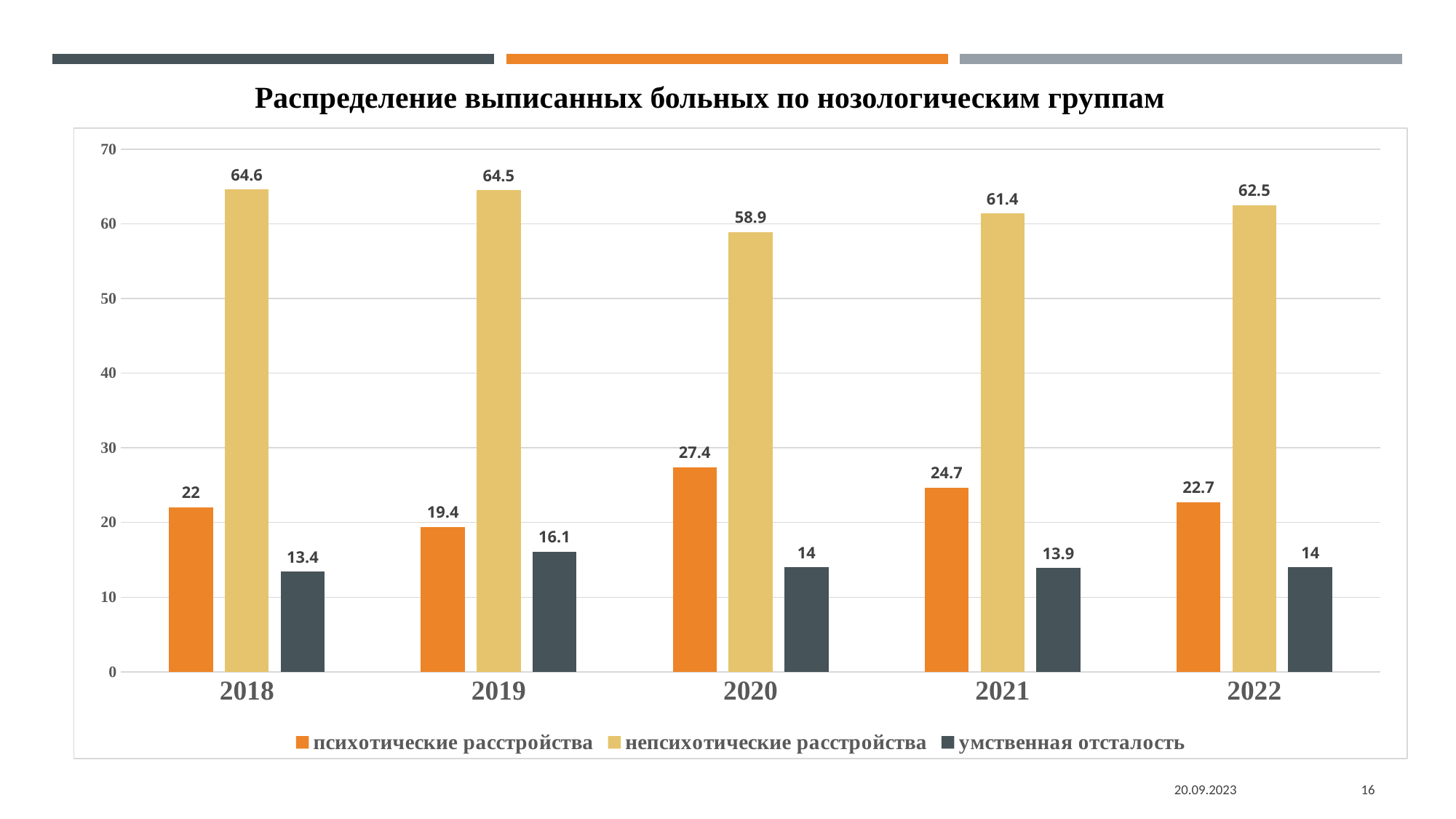
Which is larger: психотические расстройства in 2021 or психотические расстройства in 2022? психотические расстройства in 2021 In which year is the value for непсихотические расстройства the highest? 2018 In which year is the value for психотические расстройства the lowest? 2019 What is the title of the chart? Распределение выписанных больных по нозологическим группам What is the value for психотические расстройства in 2020? 27.4 What is the value for умственная отсталость in 2019? 16.1 How many years are shown on the x axis? 5 What kind of chart is shown on the slide? bar chart How many series does the legend list? 3 What is the value for непсихотические расстройства in 2022? 62.5 Does the value for непсихотические расстройства rise or fall from 2018 to 2020? fall What is the difference between the непсихотические расстройства values in 2018 and 2020? 5.7